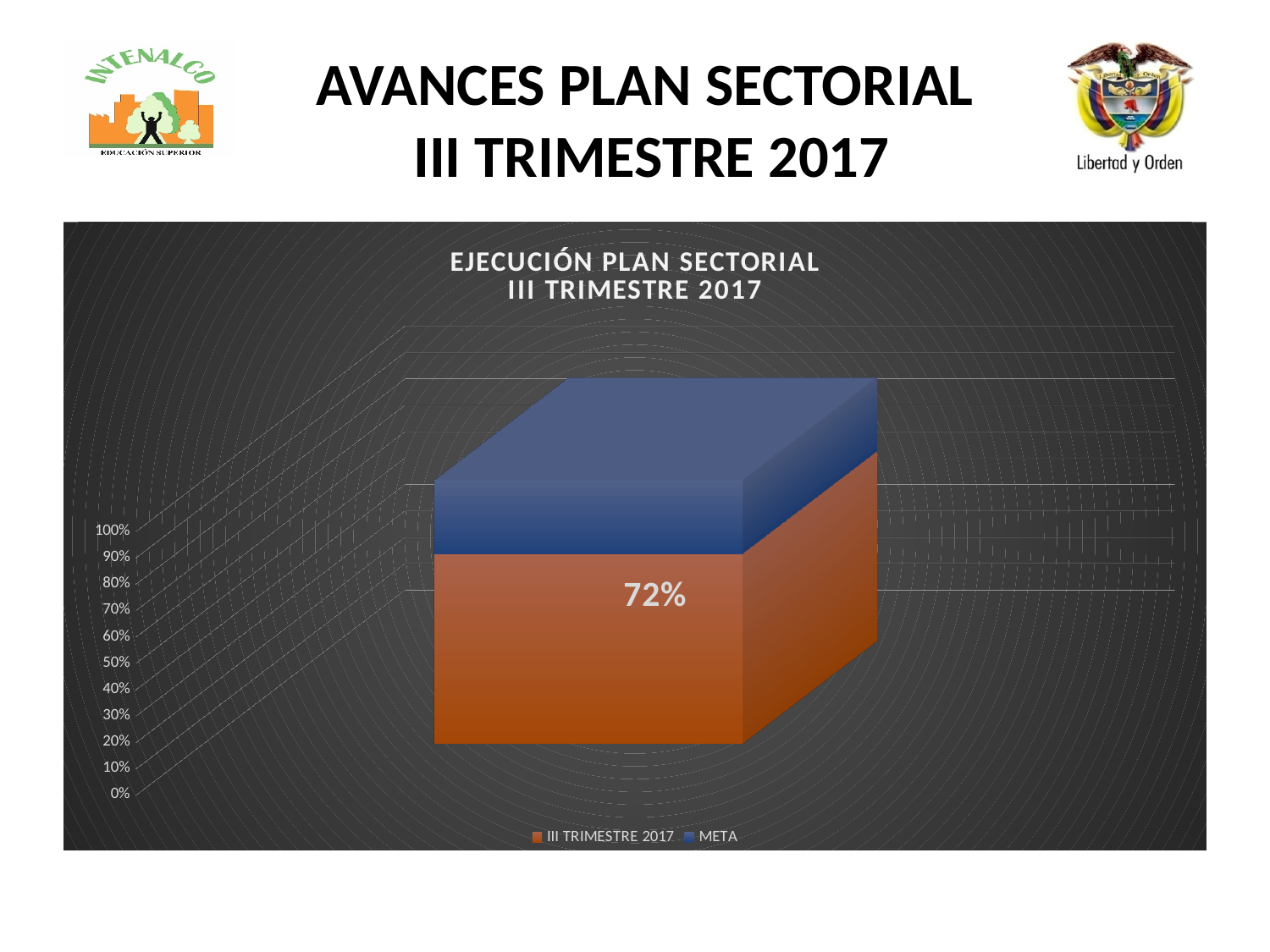
Is the value for III TRIMESTRE 2017 greater or less than 80%? less What is the value shown for the III TRIMESTRE 2017 series in the chart? 72% Which series is shown in orange in the chart? III TRIMESTRE 2017 How many series does the chart legend list? 2 How many bars are plotted in the chart? 1 What kind of chart is shown on the slide? Bar chart What is the title of the chart? EJECUCIÓN PLAN SECTORIAL III TRIMESTRE 2017 Is the value for III TRIMESTRE 2017 greater or less than 50%? greater